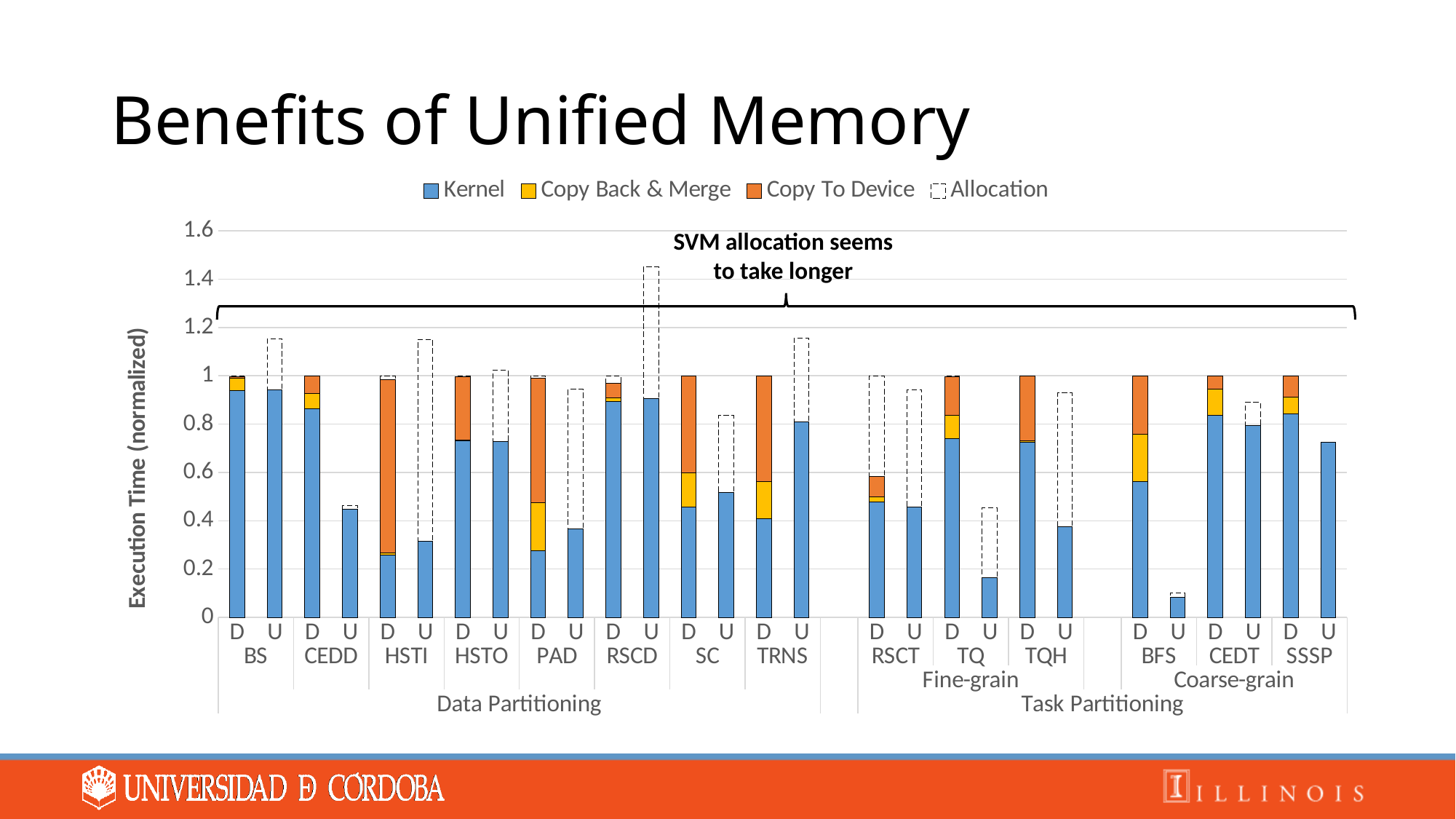
What is the label of the y axis? Execution Time (normalized) What kind of chart is shown on the slide? Stacked bar chart Which legend entry is drawn with a dashed outline instead of a solid fill? Allocation Is the top of the dashed Allocation box for RSCD U greater or less than 1.2? greater Which benchmark's U bar has the tallest dashed Allocation box? HSTI Is the solid bar for SSSP U greater or less than 0.6? greater How many benchmarks (category groups such as BS, CEDD, etc.) are shown along the x axis? 14 Is the solid bar for BFS U greater or less than 0.2? less Which benchmark has the lowest solid U bar? BFS Which is larger, the solid bar for BFS D or the solid bar for BFS U? BFS D How many series does the legend list? 4